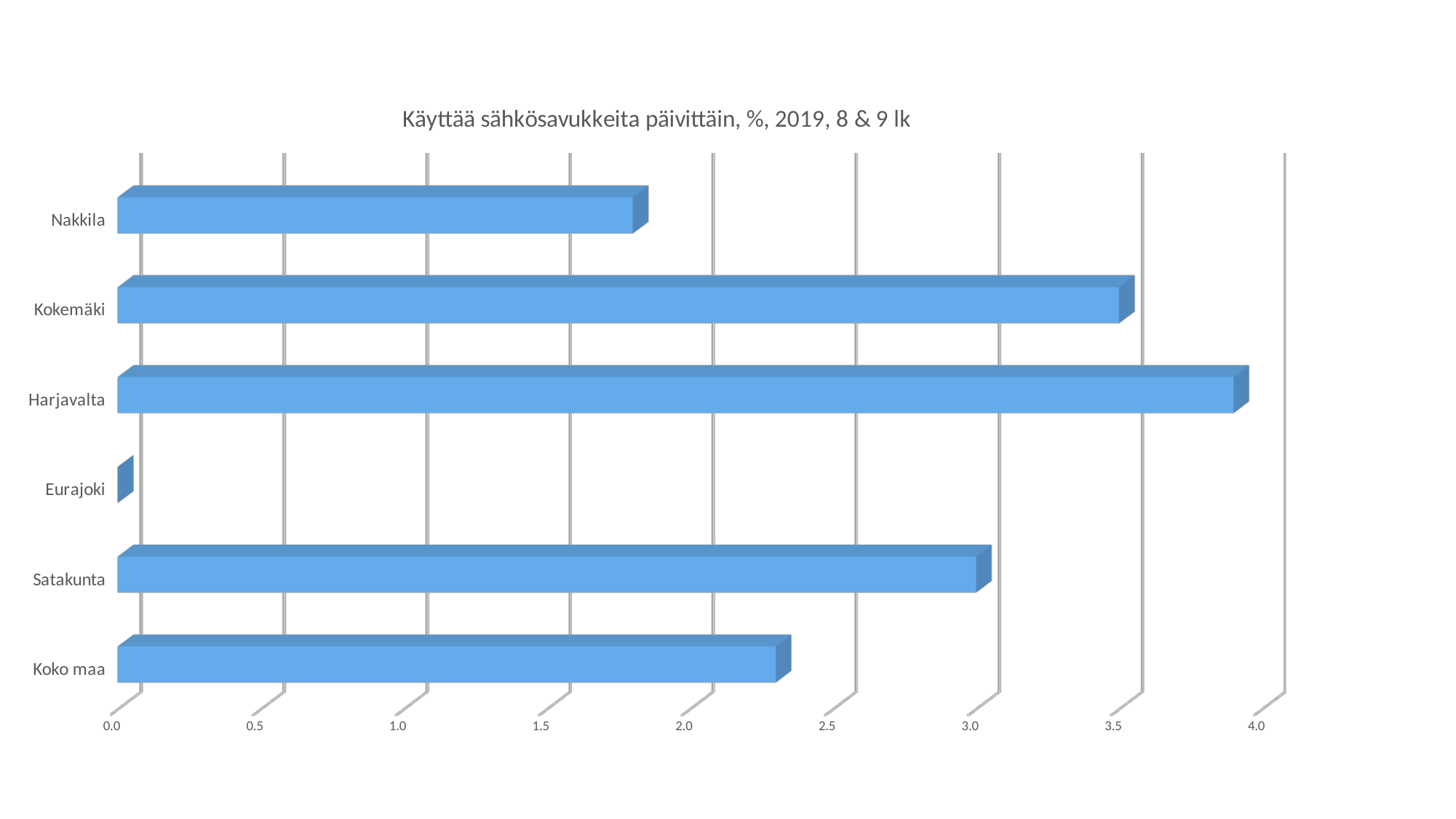
What type of chart is shown on the slide? bar chart Which category has the lowest value? Eurajoki Which category has the highest value? Harjavalta Is the value for Kokemäki greater or less than 3.0? greater Is the value for Harjavalta greater or less than 3.5? greater Is the value for Koko maa greater or less than 2.0? greater How many categories are shown in the chart? 6 Which has a larger value, Kokemäki or Satakunta? Kokemäki Which has a larger value, Nakkila or Koko maa? Koko maa What is the title of the chart? Käyttää sähkösavukkeita päivittäin, %, 2019, 8 & 9 lk